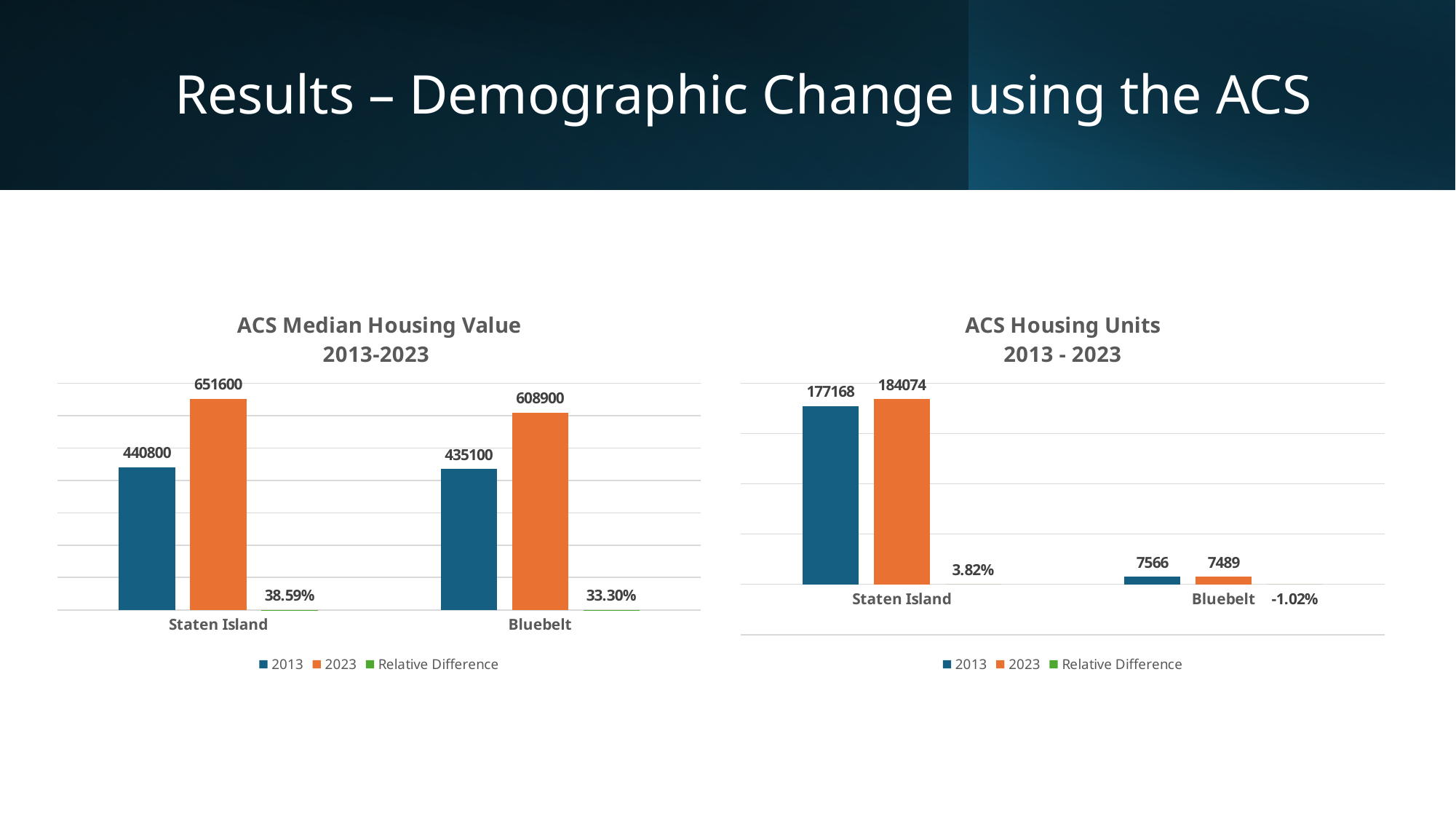
What kind of chart is the ACS Median Housing Value 2013-2023 chart? Bar chart How many series does the legend of the ACS Housing Units 2013 - 2023 chart list? 3 In the ACS Median Housing Value 2013-2023 chart, what is the 2023 value for Bluebelt? 608900 In the ACS Median Housing Value 2013-2023 chart, what is the Relative Difference for Staten Island? 38.59% In the ACS Median Housing Value 2013-2023 chart, what is the 2013 value for Staten Island? 440800 In the ACS Housing Units 2013 - 2023 chart, what is the 2023 value for Staten Island? 184074 In the ACS Median Housing Value 2013-2023 chart, what is the difference between the 2023 and 2013 values for Staten Island? 210800 In the ACS Median Housing Value 2013-2023 chart, which category has the higher 2023 value, Staten Island or Bluebelt? Staten Island In the ACS Housing Units 2013 - 2023 chart, what is the difference between the 2013 and 2023 values for Bluebelt? 77 In the ACS Housing Units 2013 - 2023 chart, what is the 2013 value for Bluebelt? 7566 In the ACS Housing Units 2013 - 2023 chart, which category has the lowest 2013 value? Bluebelt In the ACS Housing Units 2013 - 2023 chart, what is the Relative Difference for Bluebelt? -1.02%